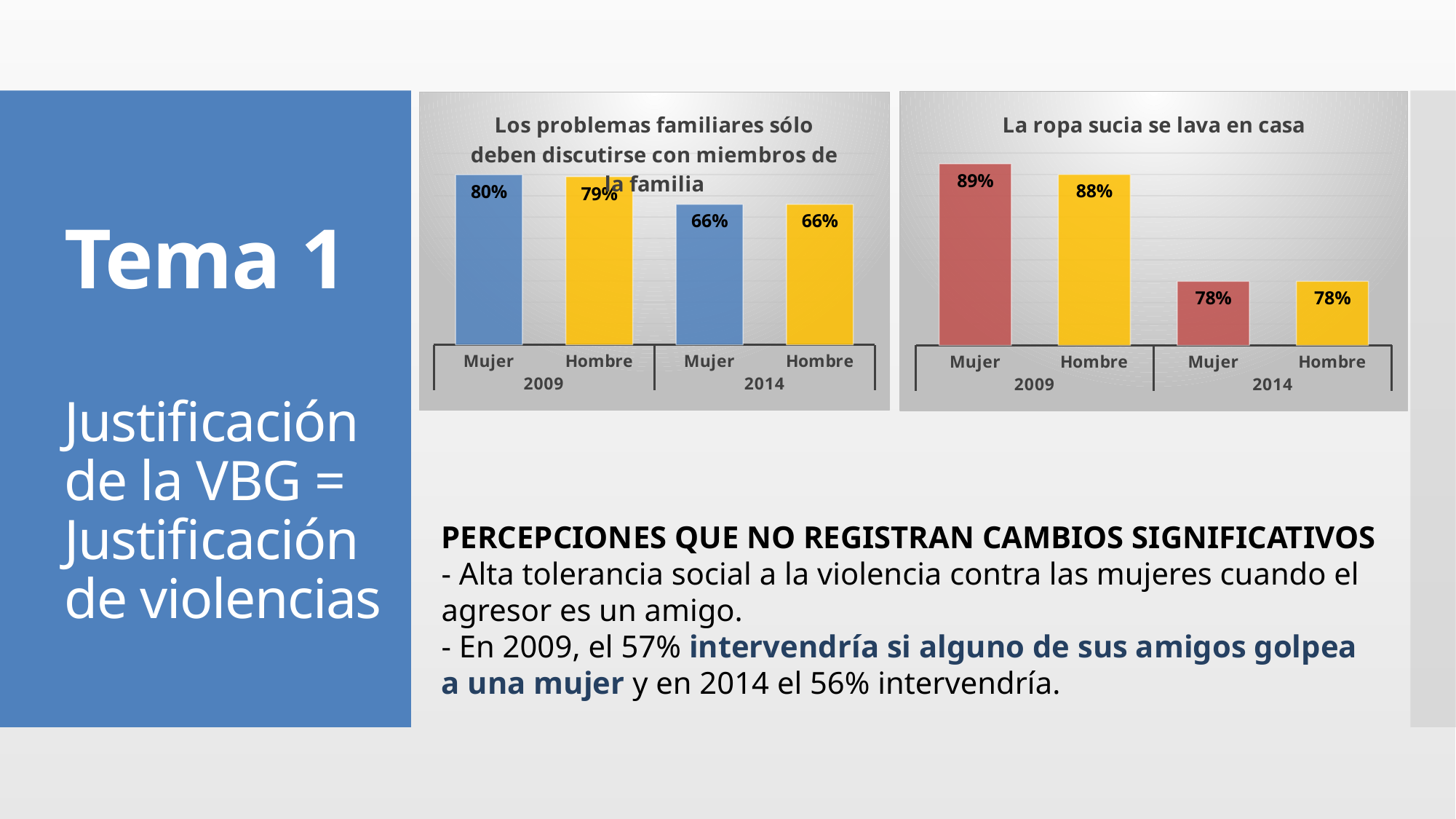
In the chart titled 'La ropa sucia se lava en casa', what colour are the Mujer bars? red In the chart titled 'La ropa sucia se lava en casa', what is the difference between the Hombre value in 2009 and the Hombre value in 2014? 10% In the chart titled 'La ropa sucia se lava en casa', do the values rise or fall from 2009 to 2014? fall How many bars are plotted in the chart titled 'Los problemas familiares sólo deben discutirse con miembros de la familia'? 4 In the chart titled 'Los problemas familiares sólo deben discutirse con miembros de la familia', which is larger: Mujer 2009 or Hombre 2009? Mujer 2009 In the chart titled 'Los problemas familiares sólo deben discutirse con miembros de la familia', what is the value for Hombre in 2014? 66% In the chart titled 'Los problemas familiares sólo deben discutirse con miembros de la familia', what is the difference between the Mujer value in 2009 and the Mujer value in 2014? 14% In the chart titled 'La ropa sucia se lava en casa', which bar has the highest value? Mujer 2009 What kind of chart is the chart titled 'La ropa sucia se lava en casa'? bar chart In the chart titled 'Los problemas familiares sólo deben discutirse con miembros de la familia', what is the value for Mujer in 2009? 80% In the chart titled 'La ropa sucia se lava en casa', what is the value for Mujer in 2009? 89% In the chart titled 'La ropa sucia se lava en casa', what is the value for Hombre in 2014? 78%